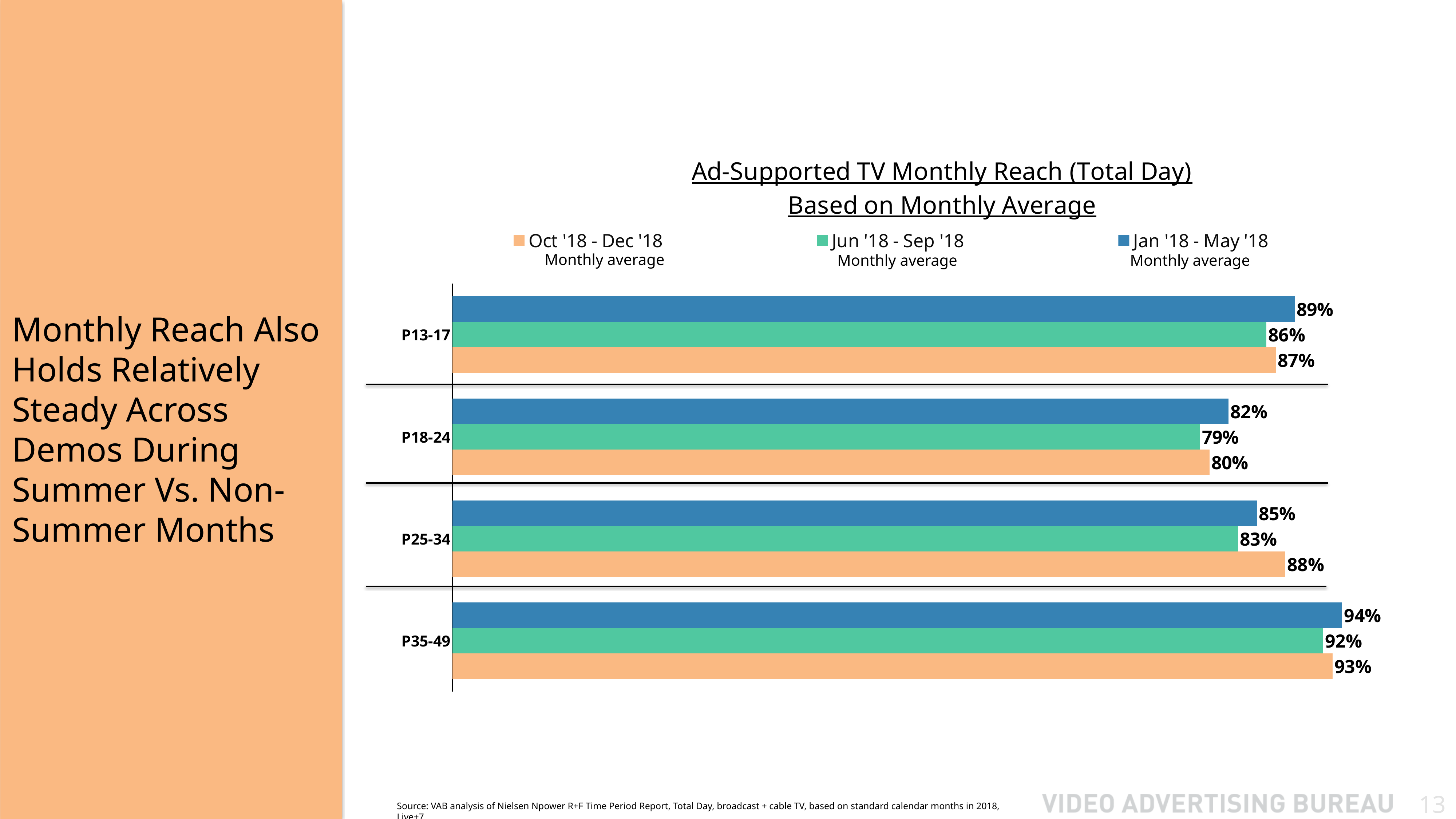
How many series does the legend list? 3 What is the difference between the Jan '18 - May '18 and Jun '18 - Sep '18 values for P25-34? 2% Which demo has the lowest Jun '18 - Sep '18 monthly average reach? P18-24 Which demo has the highest Jan '18 - May '18 monthly average reach? P35-49 What is the Oct '18 - Dec '18 monthly average reach for P25-34? 88% What kind of chart is shown on the slide? Bar chart What is the Jun '18 - Sep '18 monthly average reach for P18-24? 79% What is the Jan '18 - May '18 monthly average reach for P13-17? 89% How many demo categories are shown in the chart? 4 What is the title of the chart? Ad-Supported TV Monthly Reach (Total Day) Based on Monthly Average What is the Jan '18 - May '18 monthly average reach for P35-49? 94% For P25-34, which is larger: the Oct '18 - Dec '18 value or the Jan '18 - May '18 value? Oct '18 - Dec '18